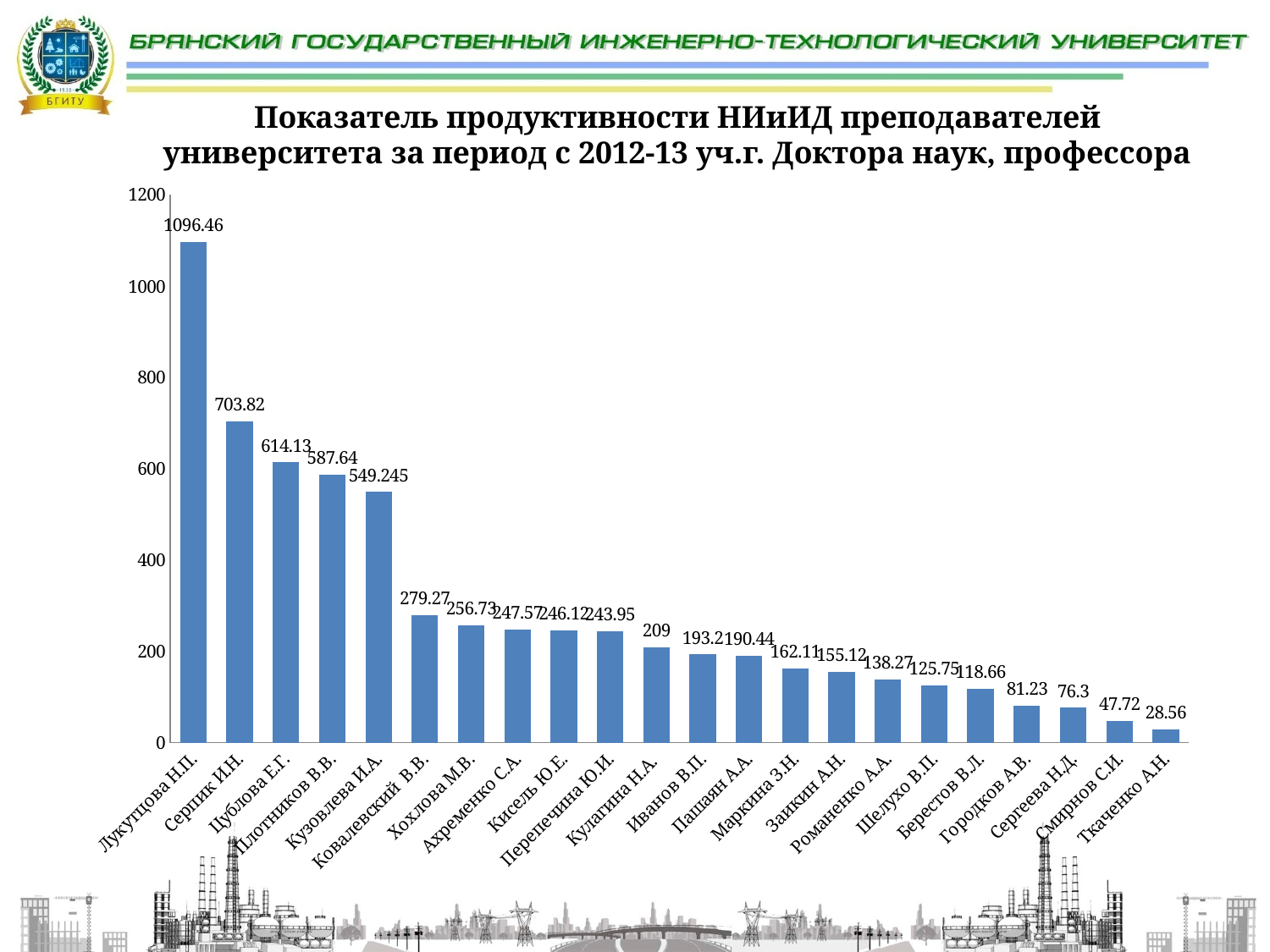
What is the difference between the values for Лукутцова Н.П. and Серпик И.Н.? 392.64 Which category has the highest value? Лукутцова Н.П. What is the value for Кулагина Н.А.? 209 What kind of chart is shown on the slide? bar chart Which category has the lowest value? Ткаченко А.Н. Which is larger, the value for Кузовлева И.А. or the value for Ковалевский В.В.? Кузовлева И.А. How many categories are shown on the x axis? 22 What is the value for Лукутцова Н.П.? 1096.46 What is the difference between the values for Цублова Е.Г. and Плотников В.В.? 26.49 What is the value for Ткаченко А.Н.? 28.56 Do the values rise or fall from left to right along the x axis? fall What is the value for Серпик И.Н.? 703.82